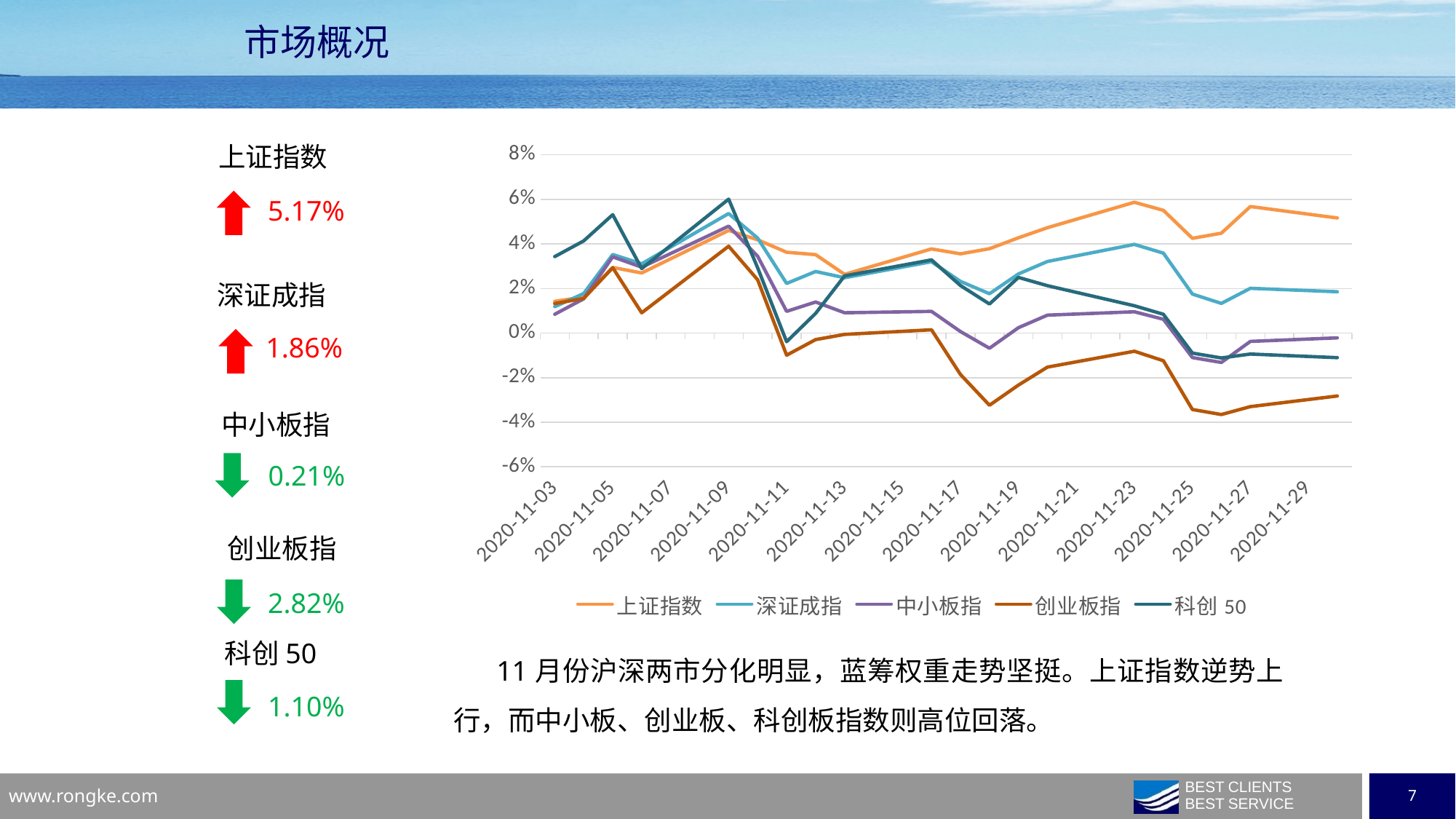
At 2020-11-09, which series is higher: 科创 50 or 创业板指? 科创 50 Is the value for 科创 50 at 2020-11-05 greater or less than 4%? greater Does the 上证指数 line rise or fall between 2020-11-17 and 2020-11-23? rise Which series has the lowest value at the last date on the chart (2020-11-29)? 创业板指 How many series does the chart legend list? 5 Is the value for 创业板指 at 2020-11-19 greater or less than -2%? less What colour is the 上证指数 line in the chart? orange Which series has the highest value at the last date on the chart (2020-11-29)? 上证指数 Is the value for 上证指数 at 2020-11-23 greater or less than 4%? greater How many date labels are shown on the x axis of the chart? 14 Does the 创业板指 line rise or fall between 2020-11-09 and 2020-11-11? fall What kind of chart is shown on the slide? line chart